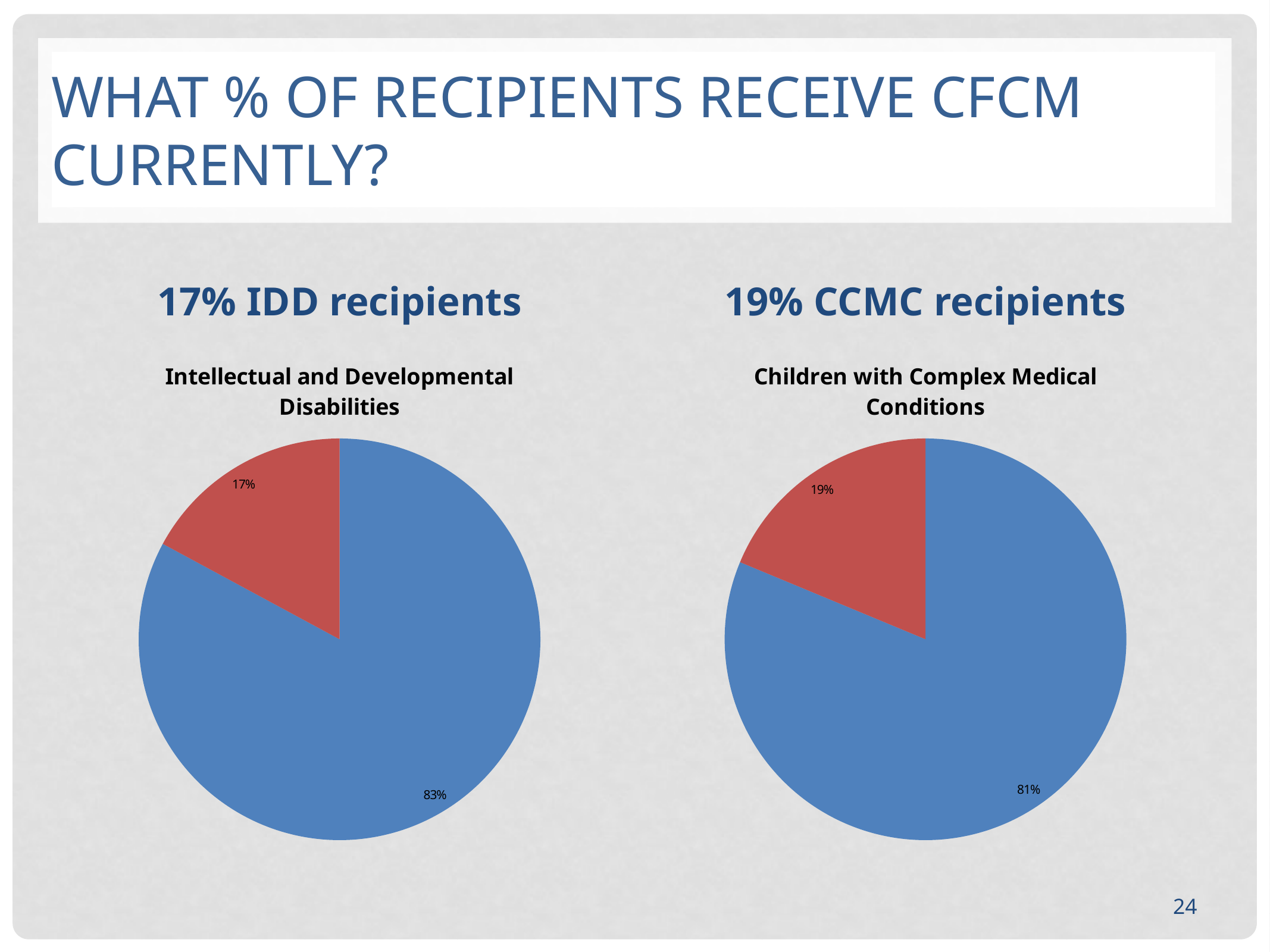
What is the difference between the red slice percentages of the two pie charts? 2 percentage points What is the difference between the blue slice and the red slice in the 'Intellectual and Developmental Disabilities' pie chart? 66 percentage points In the 'Children with Complex Medical Conditions' pie chart, what percentage is shown on the blue slice? 81% In the 'Children with Complex Medical Conditions' pie chart, which slice is the smallest? The red slice (19%) What type of chart is used for 'Intellectual and Developmental Disabilities'? Pie chart How many slices does the 'Children with Complex Medical Conditions' pie chart have? 2 What is the title of the pie chart on the right side of the slide? Children with Complex Medical Conditions In the 'Children with Complex Medical Conditions' pie chart, what percentage is shown on the red slice? 19% Which red slice is larger: the one in the 'Intellectual and Developmental Disabilities' chart or the one in the 'Children with Complex Medical Conditions' chart? Children with Complex Medical Conditions (19%) In the 'Intellectual and Developmental Disabilities' pie chart, what percentage is shown on the blue slice? 83% In the 'Intellectual and Developmental Disabilities' pie chart, what percentage is shown on the red slice? 17% In the 'Intellectual and Developmental Disabilities' pie chart, which slice is the largest? The blue slice (83%)